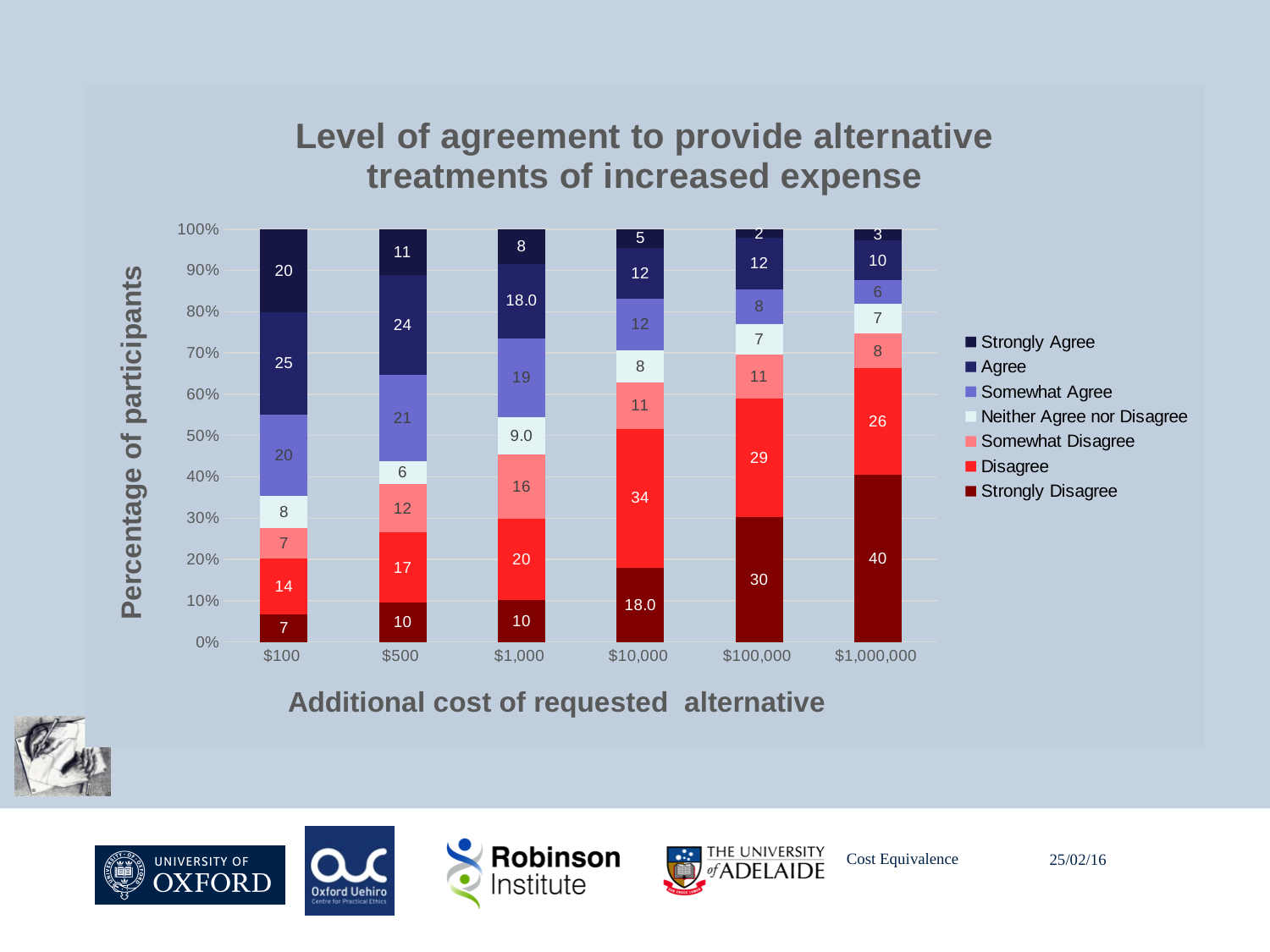
How many cost categories are shown on the x axis? 6 What is the value for Strongly Disagree at $1,000,000? 40 What is the value for Disagree at $10,000? 34 What is the value for Neither Agree nor Disagree at $1,000? 9.0 What is the difference between the Disagree value at $10,000 and the Disagree value at $100? 20 How many series does the legend list? 7 What is the value for Agree at $100? 25 Which is larger: the Agree value at $100 or the Agree value at $1,000,000? $100 Does the Strongly Disagree value rise or fall as the additional cost increases along the x axis? Rises Which cost category has the lowest value for Strongly Agree? $100,000 Which cost category has the highest value for Strongly Disagree? $1,000,000 What kind of chart is this? Stacked bar chart